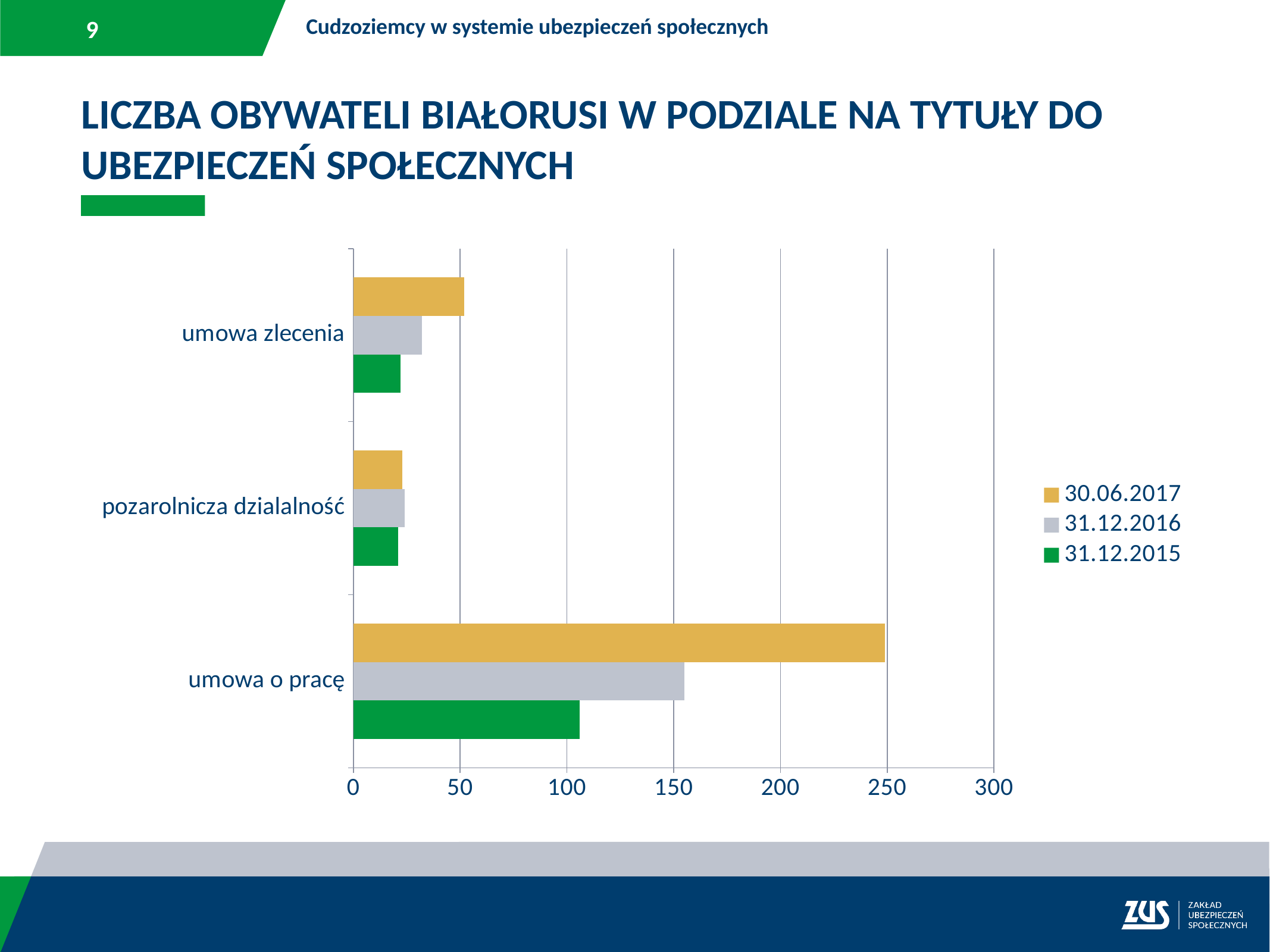
Which category has the highest value for the 31.12.2015 series? umowa o pracę How many categories are shown on the chart? 3 Is the value for umowa o pracę in the 31.12.2015 series greater or less than 150? less For umowa o pracę, which series has the larger value: 31.12.2016 or 31.12.2015? 31.12.2016 Is the value for umowa o pracę in the 30.06.2017 series greater or less than 200? greater Which category has the lowest value for the 30.06.2017 series? pozarolnicza dzialalność For umowa zlecenia, which series has the larger value: 30.06.2017 or 31.12.2016? 30.06.2017 Is the value for umowa zlecenia in the 31.12.2015 series greater or less than 50? less What kind of chart is shown on the slide? bar chart How many series does the legend list? 3 Which legend entry is shown in green? 31.12.2015 Which category has the highest value for the 30.06.2017 series? umowa o pracę